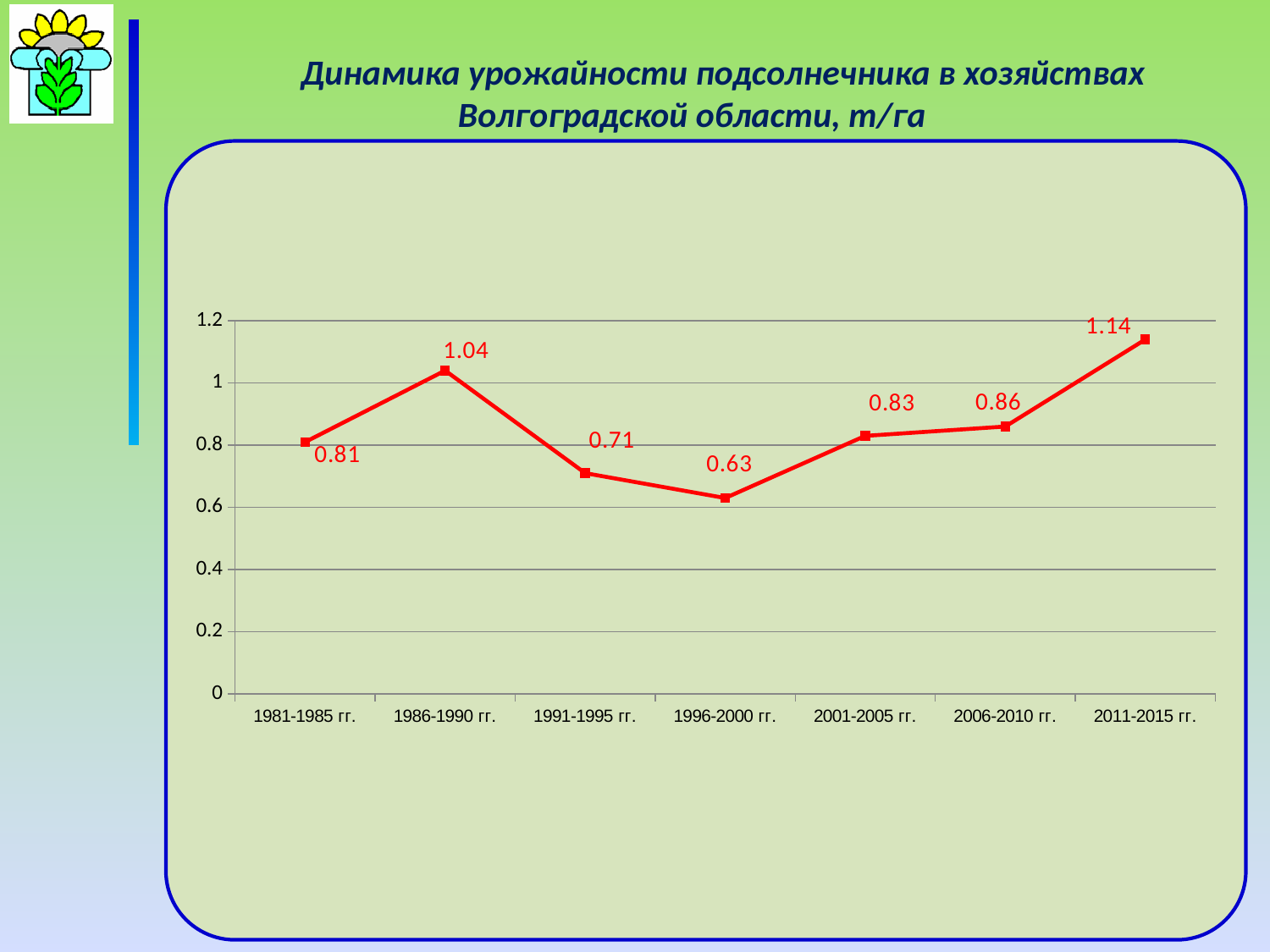
Is the value for 2001-2005 гг. greater or less than 1? less What is the value plotted for 2006-2010 гг.? 0.86 Which is larger, the value for 1986-1990 гг. or the value for 2006-2010 гг.? 1986-1990 гг. What is the difference between the values for 1986-1990 гг. and 1991-1995 гг.? 0.33 How many periods are plotted on the x axis? 7 Which period has the highest yield? 2011-2015 гг. What kind of chart is shown on the slide? line chart Which period has the lowest yield? 1996-2000 гг. What is the difference between the values for 2011-2015 гг. and 1981-1985 гг.? 0.33 What is the sunflower yield for 1981-1985 гг.? 0.81 What is the value plotted for 1996-2000 гг.? 0.63 Does the yield rise or fall from 1996-2000 гг. to 2011-2015 гг.? rise